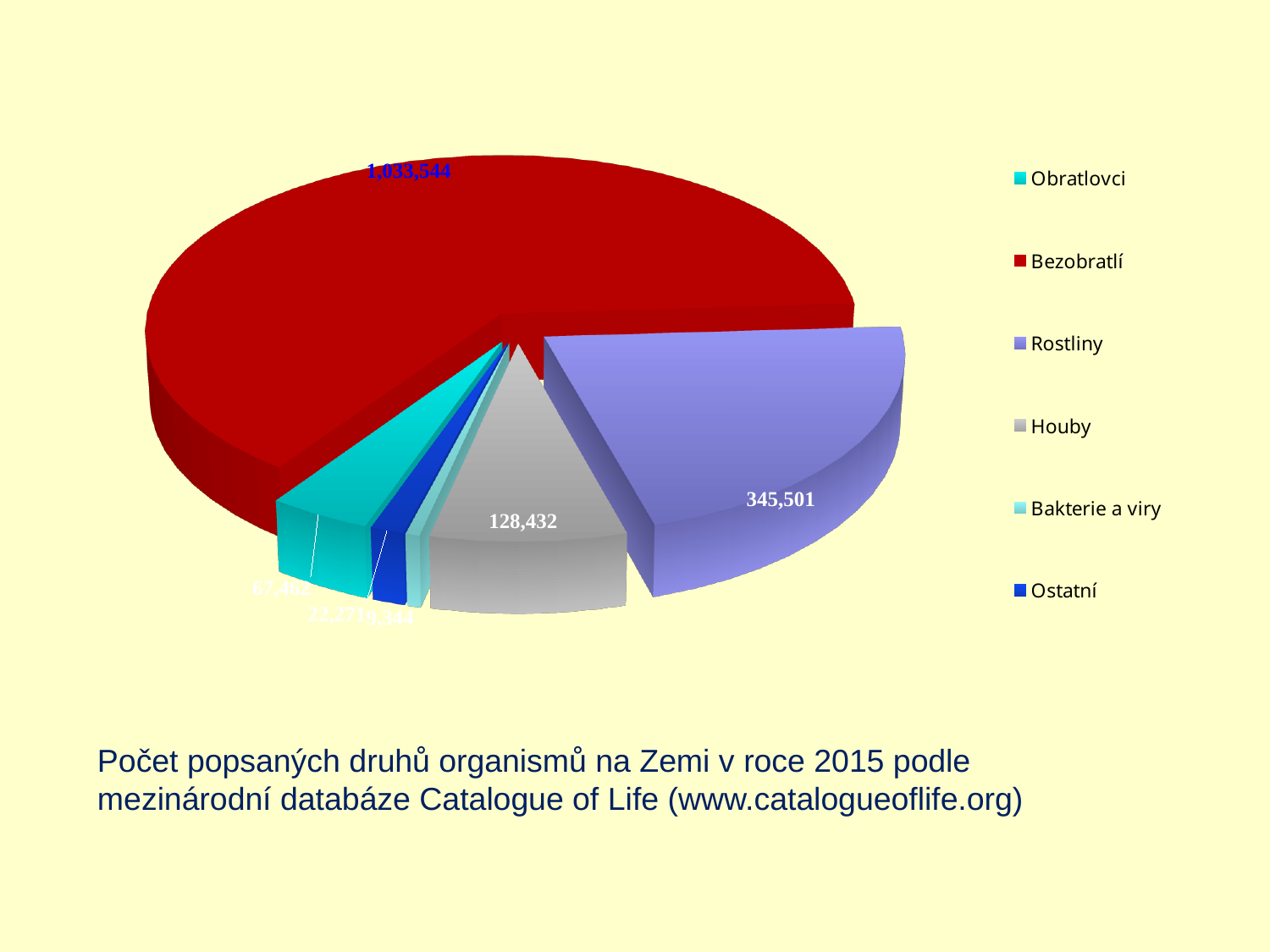
Which category is listed first in the legend? Obratlovci What is the value shown for Rostliny? 345,501 What is the value shown for Bezobratlí? 1,033,544 How many categories does the legend of the pie chart list? 6 What is the difference between the values for Rostliny and Houby? 217,069 Which is larger, the value for Rostliny or the value for Houby? Rostliny What is the value shown for Houby? 128,432 Which is larger, the value for Bezobratlí or the value for Rostliny? Bezobratlí What is the difference between the values for Bezobratlí and Rostliny? 688,043 What kind of chart is shown on the slide? pie chart What colour is the Bezobratlí slice? red Which category has the largest slice of the pie? Bezobratlí